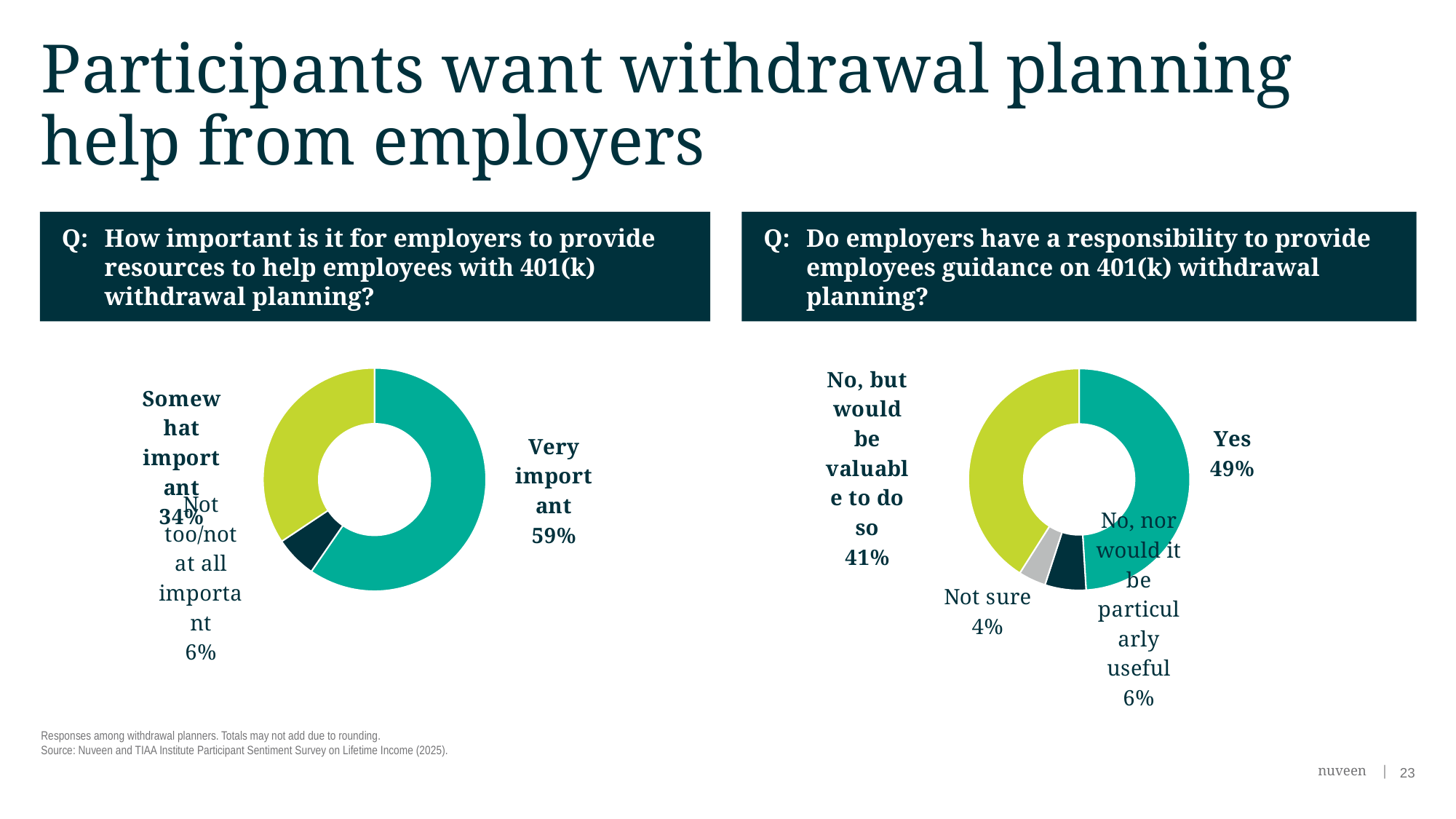
What type of chart is used on this slide? Donut (pie) chart In the left chart (how important is it for employers to provide resources), how many response categories are shown? 3 In the right chart (do employers have a responsibility to provide guidance), what share answered 'No, but would be valuable to do so'? 41% In the right chart (do employers have a responsibility to provide guidance), how many response categories are shown? 4 In the right chart (do employers have a responsibility to provide guidance), what share answered 'Not sure'? 4% In the left chart (how important is it for employers to provide resources), what share of respondents said 'Somewhat important'? 34% In the right chart (do employers have a responsibility to provide guidance), which response has the largest share? Yes In the right chart (do employers have a responsibility to provide guidance), what share of respondents answered 'Yes'? 49% In the left chart (how important is it for employers to provide resources), what share of respondents said 'Very important'? 59% In the left chart (how important is it for employers to provide resources), which response has the smallest share? Not too/not at all important In the left chart (how important is it for employers to provide resources), what is the difference in percentage points between 'Very important' and 'Somewhat important'? 25 percentage points In the right chart (do employers have a responsibility to provide guidance), which is larger: 'Yes' or 'No, but would be valuable to do so'? Yes